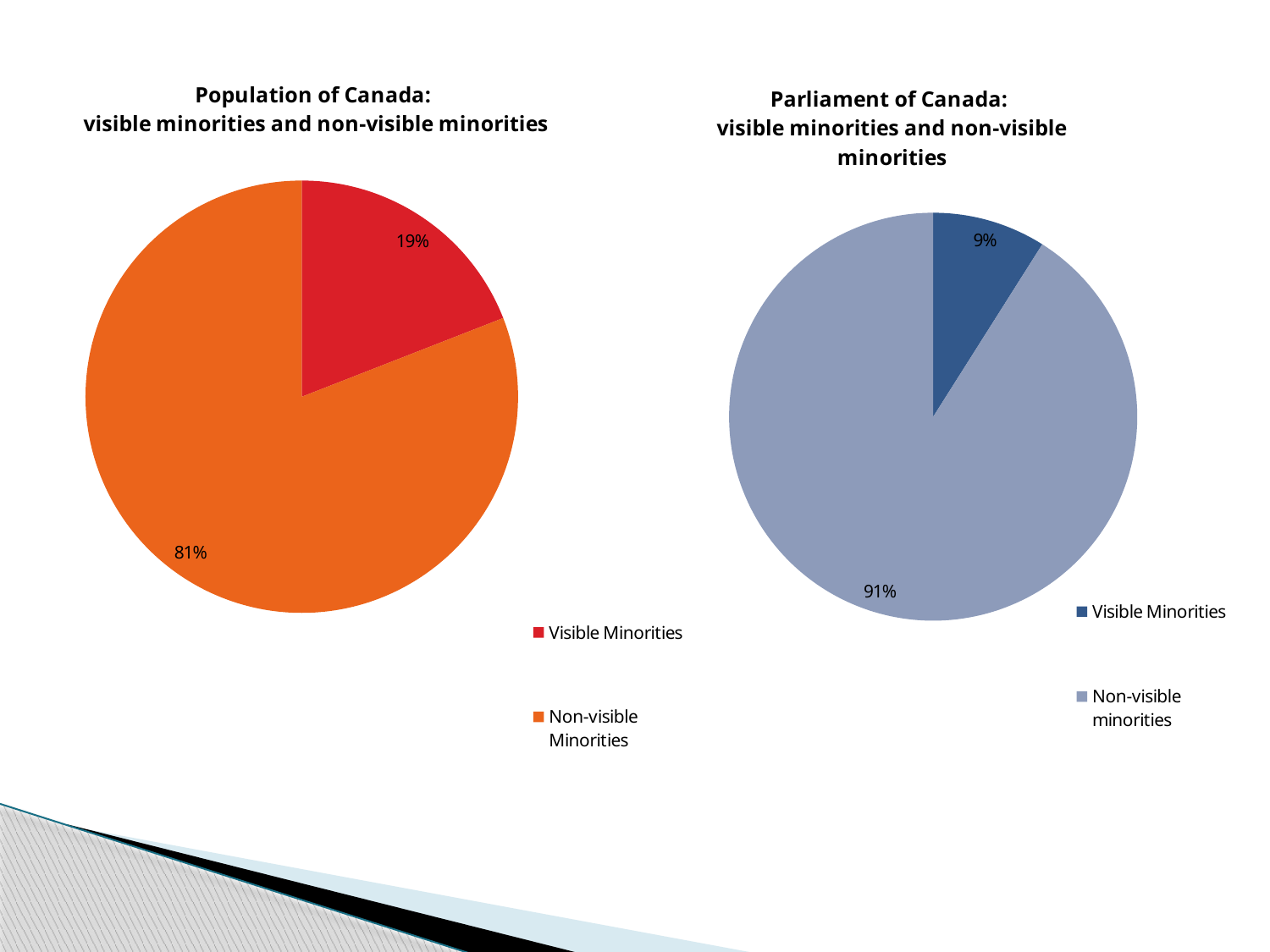
In the 'Parliament of Canada' pie chart, which slice is the smallest? Visible Minorities In the 'Population of Canada' pie chart, what share is labelled for Non-visible Minorities? 81% How many entries does the legend of the 'Parliament of Canada' chart list? 2 In the 'Population of Canada' pie chart, which slice is the largest? Non-visible Minorities What type of chart is the 'Parliament of Canada' chart? Pie chart In the 'Population of Canada' pie chart, what colour is the Visible Minorities slice? Red In the 'Population of Canada' pie chart, what share is labelled for Visible Minorities? 19% Which is larger: the Visible Minorities share in the 'Population of Canada' chart or the Visible Minorities share in the 'Parliament of Canada' chart? Population of Canada In the 'Parliament of Canada' pie chart, what share is labelled for Visible Minorities? 9% How many slices does the 'Population of Canada' pie chart have? 2 In the 'Population of Canada' pie chart, what is the difference in percentage points between the Non-visible Minorities and Visible Minorities slices? 62 In the 'Parliament of Canada' pie chart, what share is labelled for Non-visible minorities? 91%